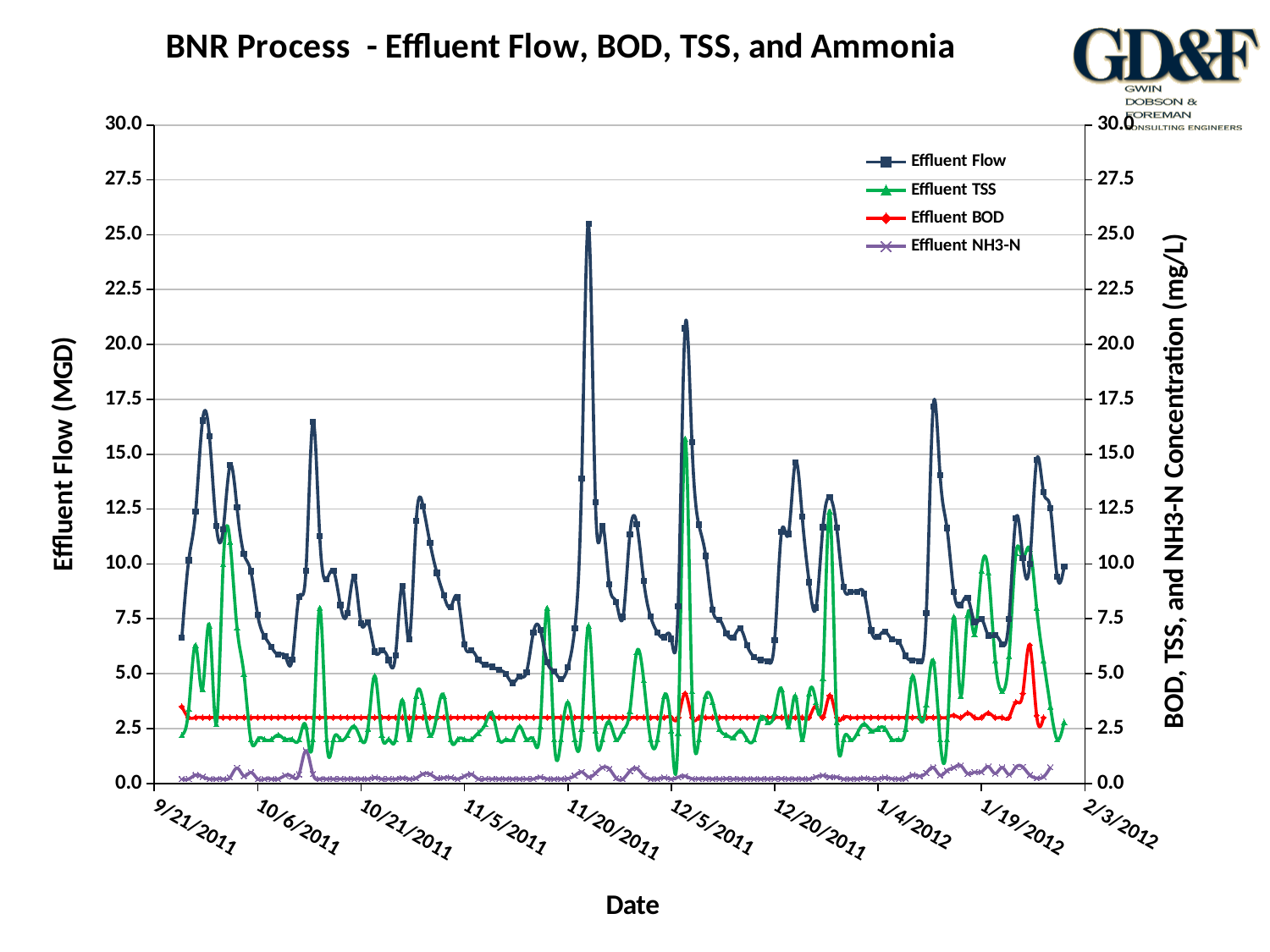
What kind of chart is shown on the slide? Line chart Which series reaches the highest peak on the chart? Effluent Flow What is the label of the left vertical axis? Effluent Flow (MGD) Is the highest peak of the Effluent TSS series (around 12/5/2011) greater or less than 12.5? greater Is the highest peak of the Effluent Flow series (around 11/20/2011) greater or less than 22.5? greater Is the highest peak of the Effluent BOD series (around 1/19/2012) greater or less than 5.0? greater What is the title of the chart? BNR Process - Effluent Flow, BOD, TSS, and Ammonia Which is larger: the Effluent Flow value at the first point (9/21/2011) or its peak shortly after, before 10/6/2011? The peak before 10/6/2011 Which series stays lowest across the whole date range? Effluent NH3-N How many series does the legend list? 4 Which is larger: the Effluent Flow peak near 11/20/2011 or the Effluent Flow peak near 12/5/2011? The peak near 11/20/2011